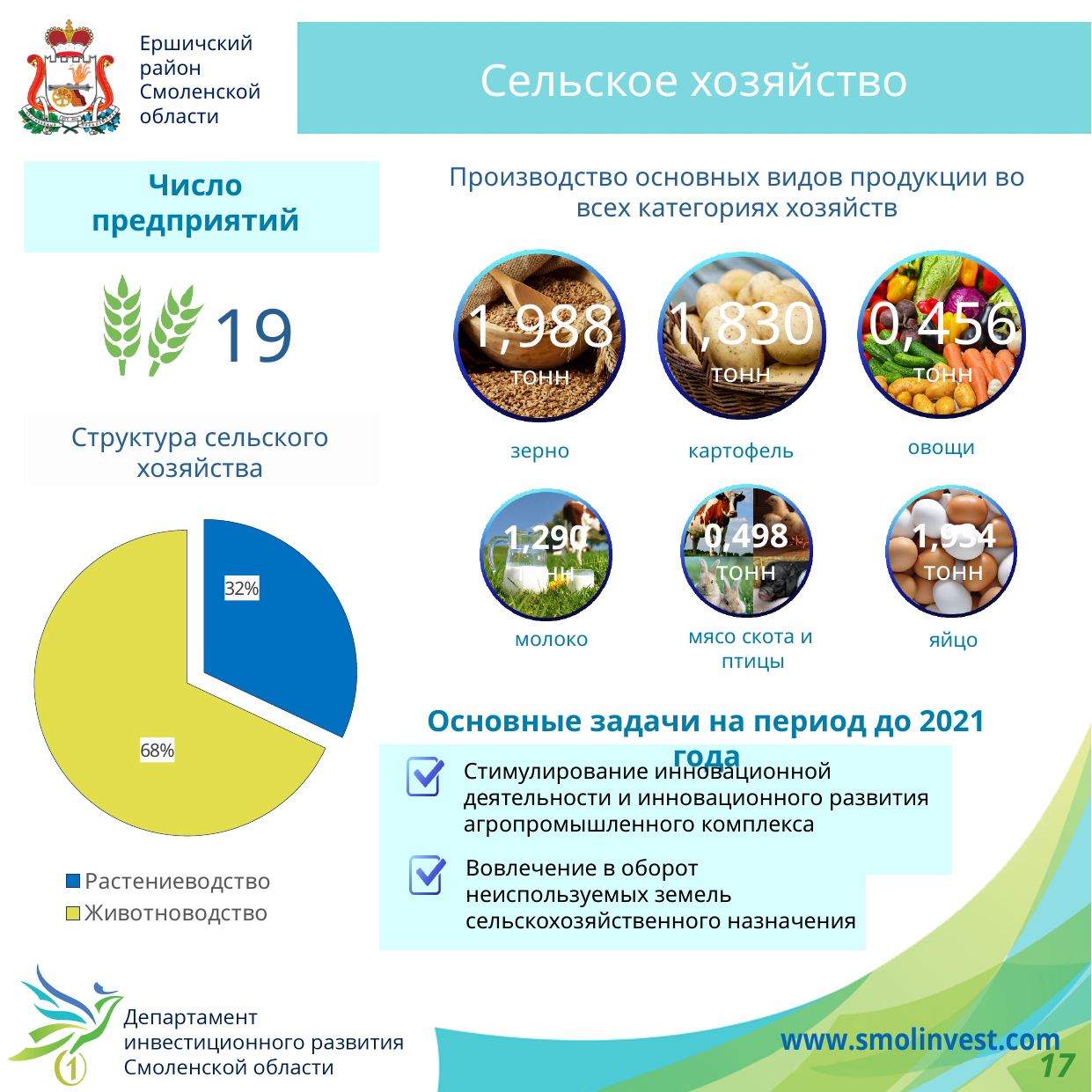
In the pie chart «Структура сельского хозяйства», what share does «Животноводство» have? 68% How many slices does the pie chart «Структура сельского хозяйства» have? 2 How many entries does the legend of the pie chart «Структура сельского хозяйства» list? 2 In the pie chart «Структура сельского хозяйства», which category has the largest share? Животноводство What kind of chart is shown under the heading «Структура сельского хозяйства»? Pie chart In the pie chart «Структура сельского хозяйства», what colour is the «Животноводство» slice? Yellow In the pie chart «Структура сельского хозяйства», what colour is the «Растениеводство» slice? Blue In the pie chart «Структура сельского хозяйства», which is larger: «Растениеводство» or «Животноводство»? Животноводство In the pie chart «Структура сельского хозяйства», is the share of «Растениеводство» greater or less than 50%? less In the pie chart «Структура сельского хозяйства», which category has the smallest share? Растениеводство In the pie chart «Структура сельского хозяйства», what share does «Растениеводство» have? 32% In the pie chart «Структура сельского хозяйства», by how many percentage points does «Животноводство» exceed «Растениеводство»? 36 percentage points